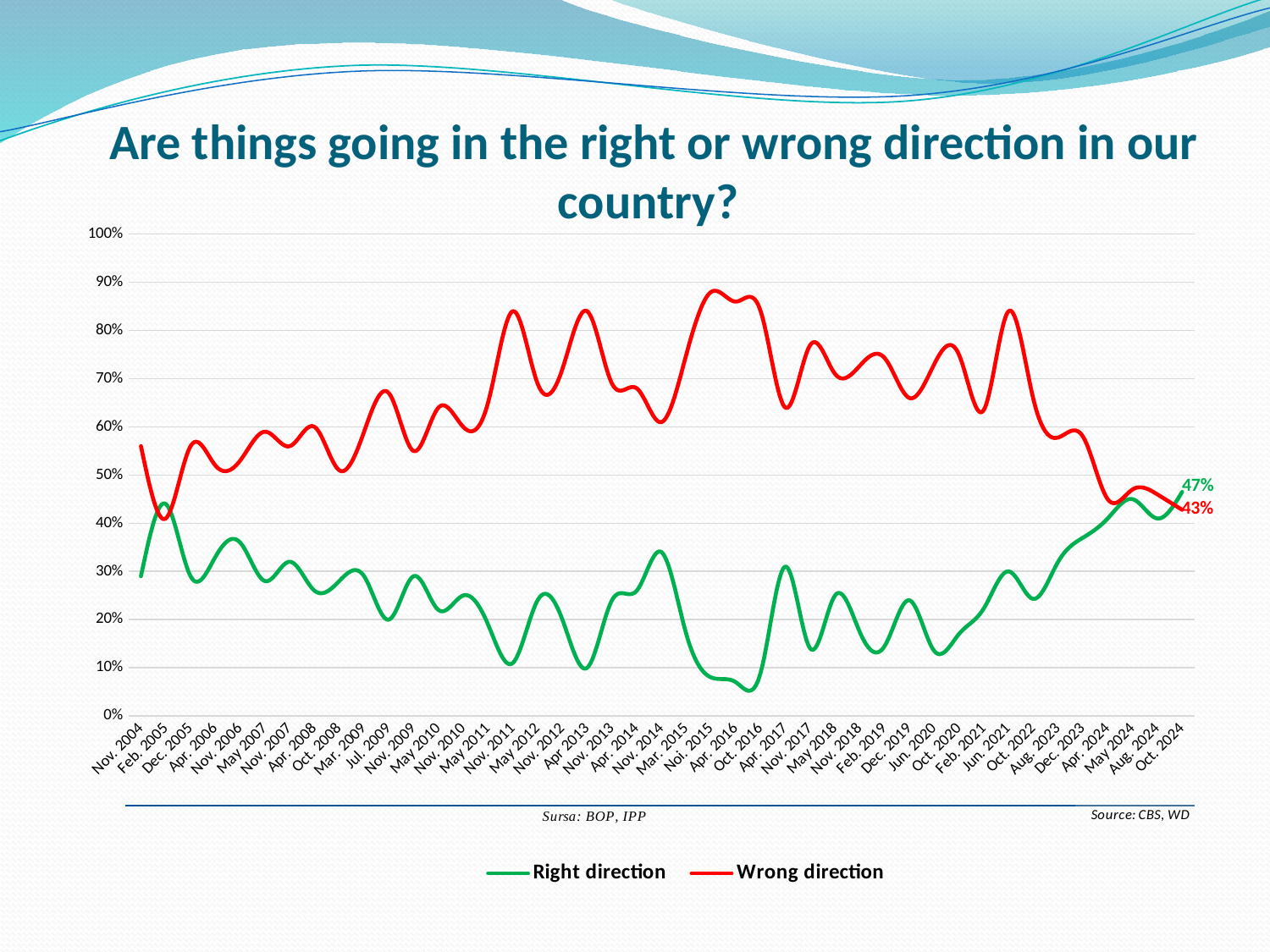
In Oct. 2024, which series has the larger value, Right direction or Wrong direction? Right direction Is the value for Right direction in Apr. 2016 greater or less than 10%? less What is the value for Right direction in Oct. 2024? 47% What kind of chart is shown on the slide? Line chart Does the Right direction line rise or fall from Oct. 2022 to Oct. 2024? rise What is the difference between the Right direction and Wrong direction values in Oct. 2024? 4% Is the value for Wrong direction in Nov. 2015 greater or less than 80%? greater What colour is the Right direction line? Green What is the value for Wrong direction in Oct. 2024? 43% How many series does the legend list? 2 Is the value for Wrong direction in Nov. 2004 greater or less than 50%? greater Does the Wrong direction line rise or fall from Jun. 2021 to Apr. 2024? fall